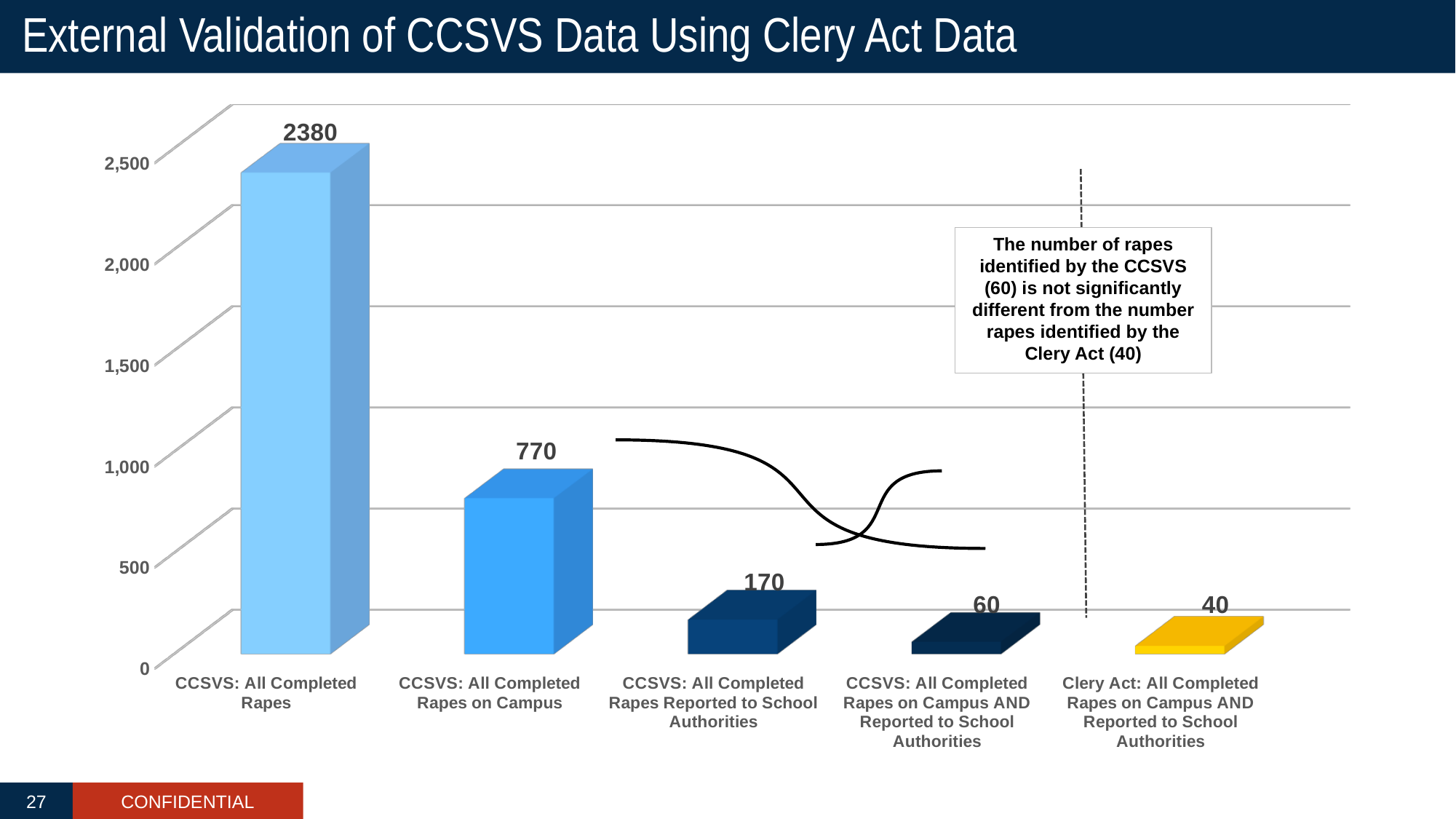
What is the value for 'CCSVS: All Completed Rapes Reported to School Authorities'? 170 What is the value for 'Clery Act: All Completed Rapes on Campus AND Reported to School Authorities'? 40 What is the value for 'CCSVS: All Completed Rapes on Campus'? 770 Which category has the highest value? CCSVS: All Completed Rapes Which category has the lowest value? Clery Act: All Completed Rapes on Campus AND Reported to School Authorities Do the values rise or fall from left to right across the categories? Fall What is the value for 'CCSVS: All Completed Rapes'? 2380 What is the difference between 'CCSVS: All Completed Rapes' and 'CCSVS: All Completed Rapes on Campus'? 1610 How many categories are shown in the chart? 5 What is the difference between 'CCSVS: All Completed Rapes on Campus AND Reported to School Authorities' and 'Clery Act: All Completed Rapes on Campus AND Reported to School Authorities'? 20 What kind of chart is shown on the slide? Bar chart Which is larger: 'CCSVS: All Completed Rapes Reported to School Authorities' or 'CCSVS: All Completed Rapes on Campus AND Reported to School Authorities'? CCSVS: All Completed Rapes Reported to School Authorities